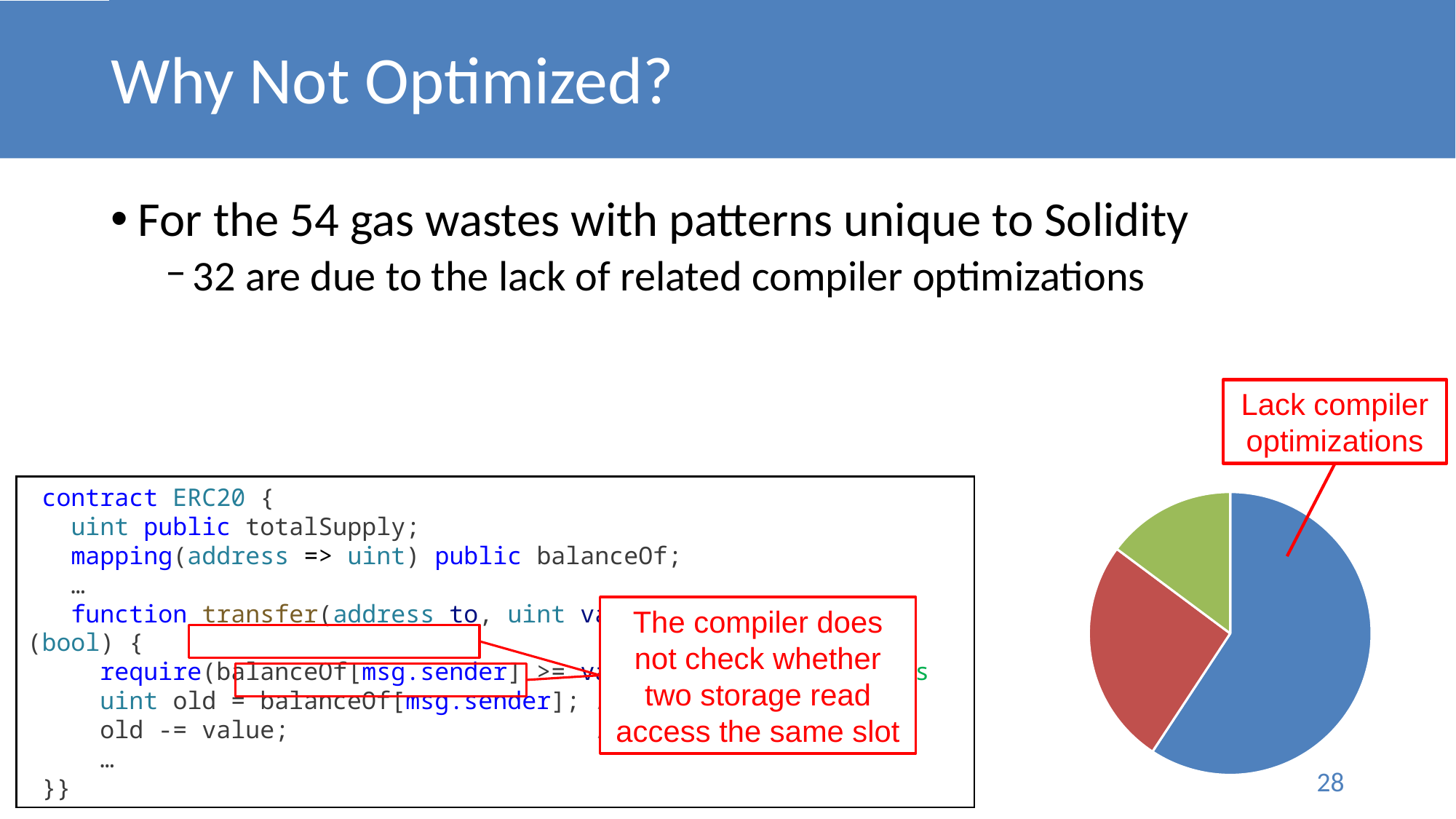
What label is attached to the blue slice of the pie chart? Lack compiler optimizations What colour is the slice labelled "Lack compiler optimizations"? blue Which is larger in the pie chart, the red slice or the green slice? red Which slice of the pie chart is the largest? Lack compiler optimizations Which is larger in the pie chart, the blue slice or the red slice? blue How many slices does the pie chart have? 3 Which colour slice of the pie chart is the smallest? green What kind of chart is shown on the slide? pie chart